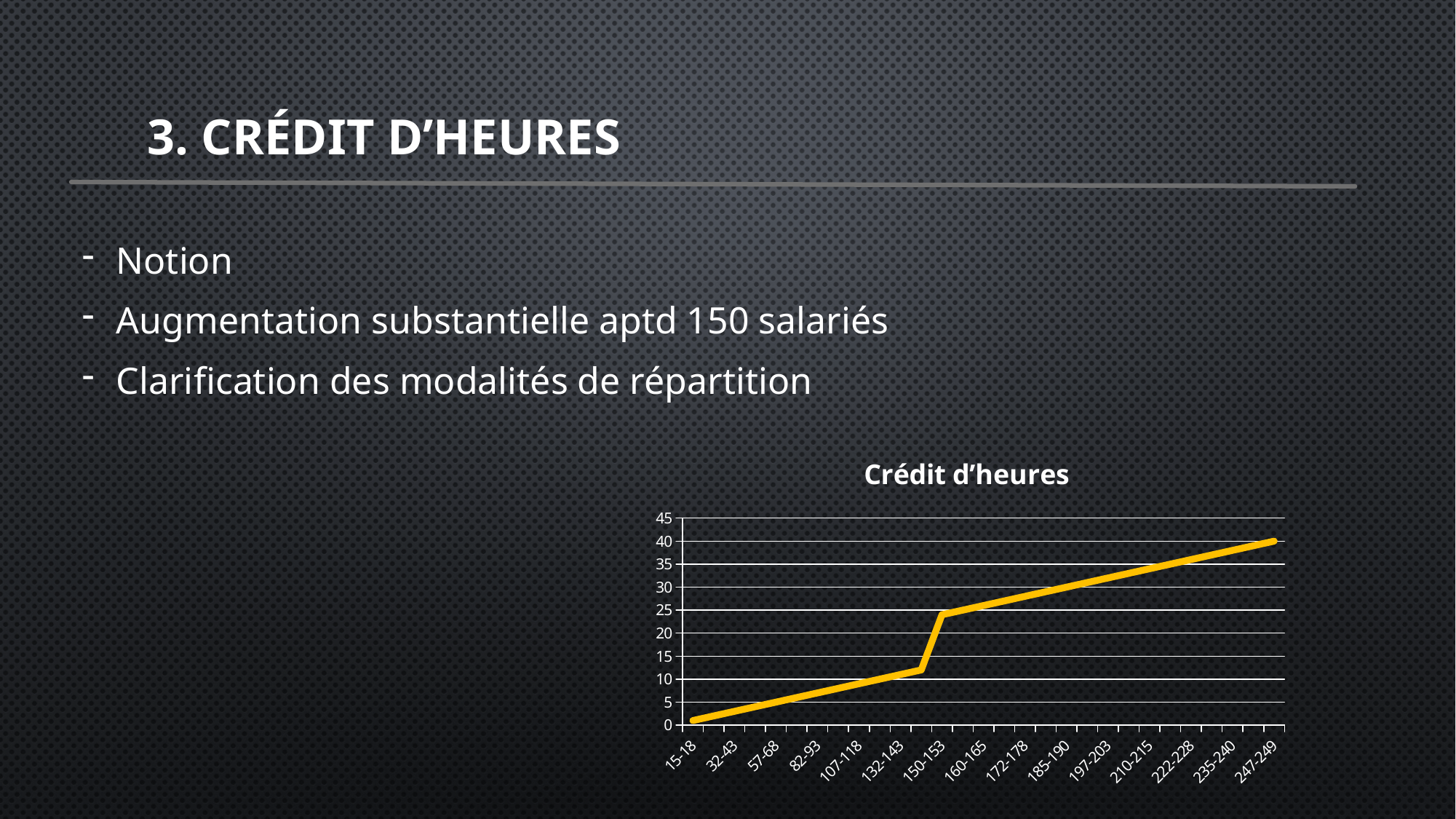
Is the value for 132-143 greater or less than 15? less Which category has the highest value in the chart? 247-249 Is the value for 15-18 greater or less than 5? less What kind of chart is shown on the slide? line chart Do the values in the chart rise or fall from left to right along the x axis? rise Is the value for 82-93 greater or less than 10? less What is the highest value shown on the vertical axis of the chart? 45 Which category has the lowest value in the chart? 15-18 What is the title of the chart? Crédit d'heures Which is larger, the value for 247-249 or the value for 15-18? 247-249